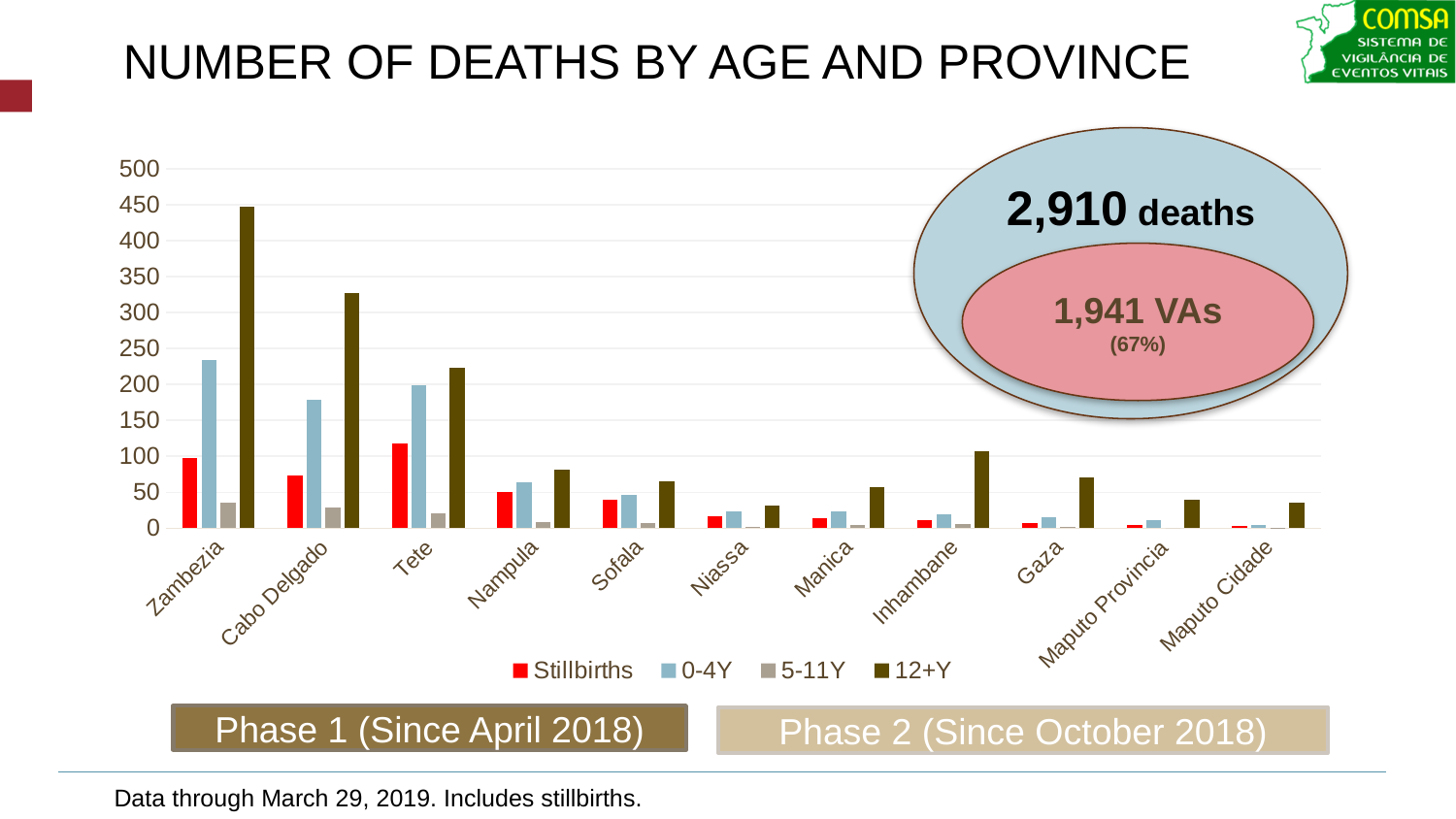
Is the 12+Y value for Cabo Delgado greater or less than 300? greater Which province has the highest value for the Stillbirths series? Tete What type of chart is shown on the slide? bar chart Which province has the highest value for the 12+Y series? Zambezia Is the 0-4Y value for Zambezia greater or less than 200? greater How many provinces are shown on the x axis of the chart? 11 Which is larger, the 0-4Y value for Zambezia or the 0-4Y value for Tete? Zambezia How many series does the chart legend list? 4 Is the 12+Y value for Nampula greater or less than 100? less What is the title of the chart on the slide? NUMBER OF DEATHS BY AGE AND PROVINCE